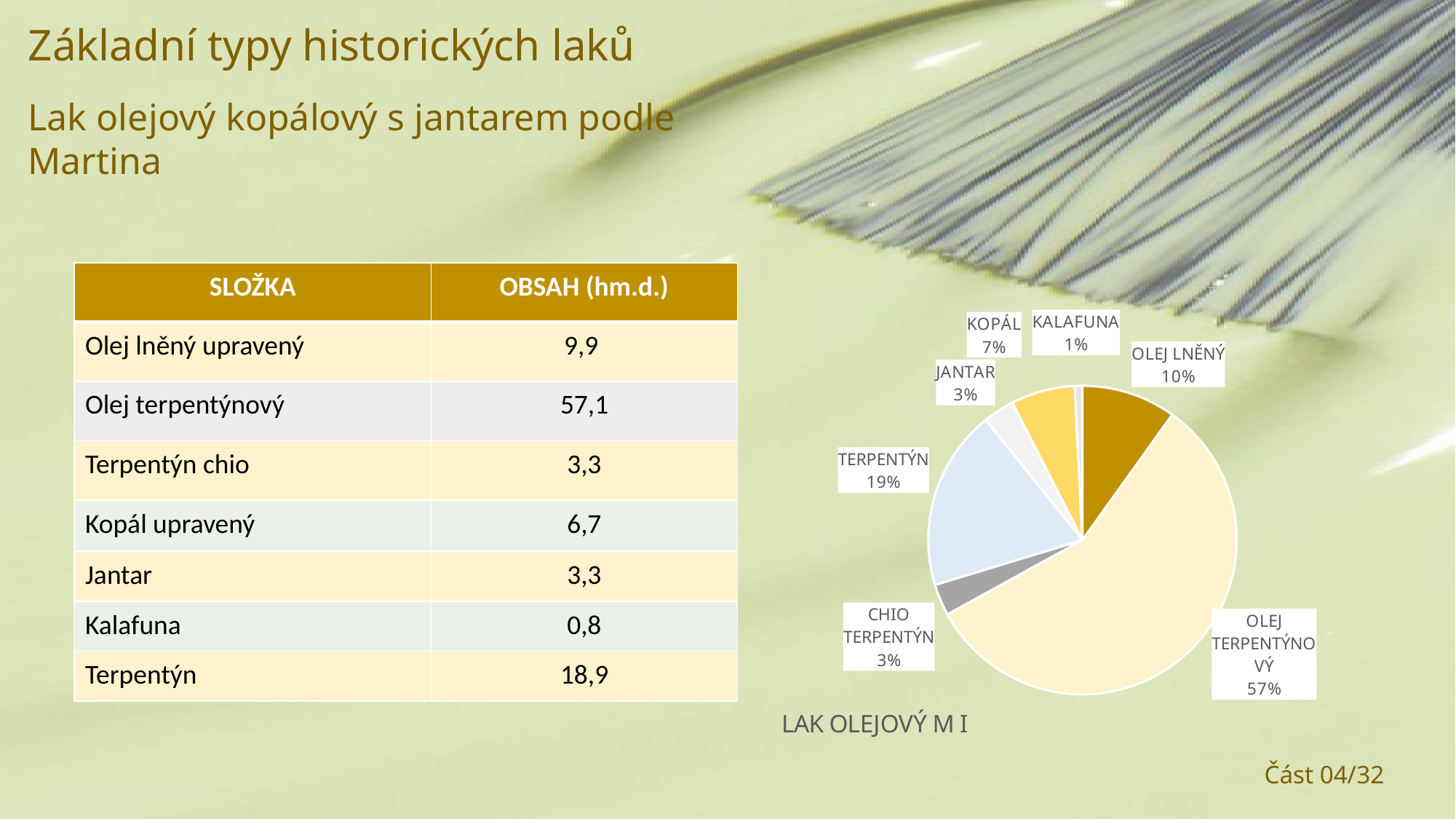
What share of the pie does OLEJ LNĚNÝ have? 10% What share of the pie does KOPÁL have? 7% What is the title of the pie chart? LAK OLEJOVÝ M I What is the difference in percentage points between the OLEJ TERPENTÝNOVÝ slice and the TERPENTÝN slice? 38 Which slice of the pie chart is the largest? OLEJ TERPENTÝNOVÝ What share of the pie does OLEJ TERPENTÝNOVÝ have? 57% How many slices does the pie chart have? 7 Which slice is larger, KOPÁL or JANTAR? KOPÁL Which slice of the pie chart is the smallest? KALAFUNA What kind of chart is shown on the slide? pie chart